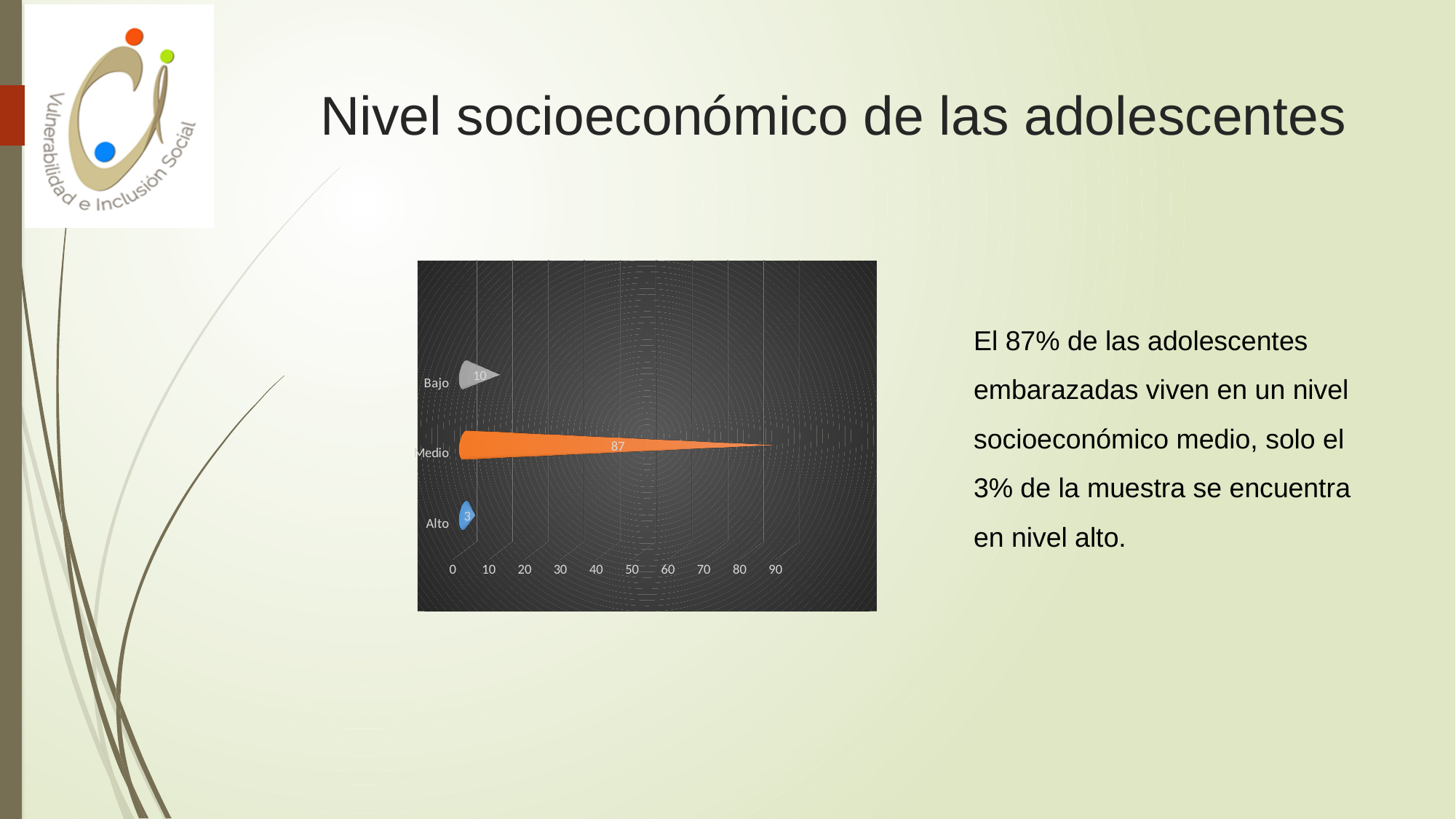
What is the value for Bajo? 10 Which category has the lowest value? Alto What colour is the bar for Medio? orange Which is larger, the value for Bajo or the value for Alto? Bajo What is the difference between the values for Medio and Bajo? 77 What is the value for Alto? 3 How many categories are shown in the chart? 3 What is the difference between the values for Bajo and Alto? 7 Is the value for Medio greater or less than 80? greater What kind of chart is shown on the slide? bar chart Which category has the highest value? Medio What is the value for Medio? 87